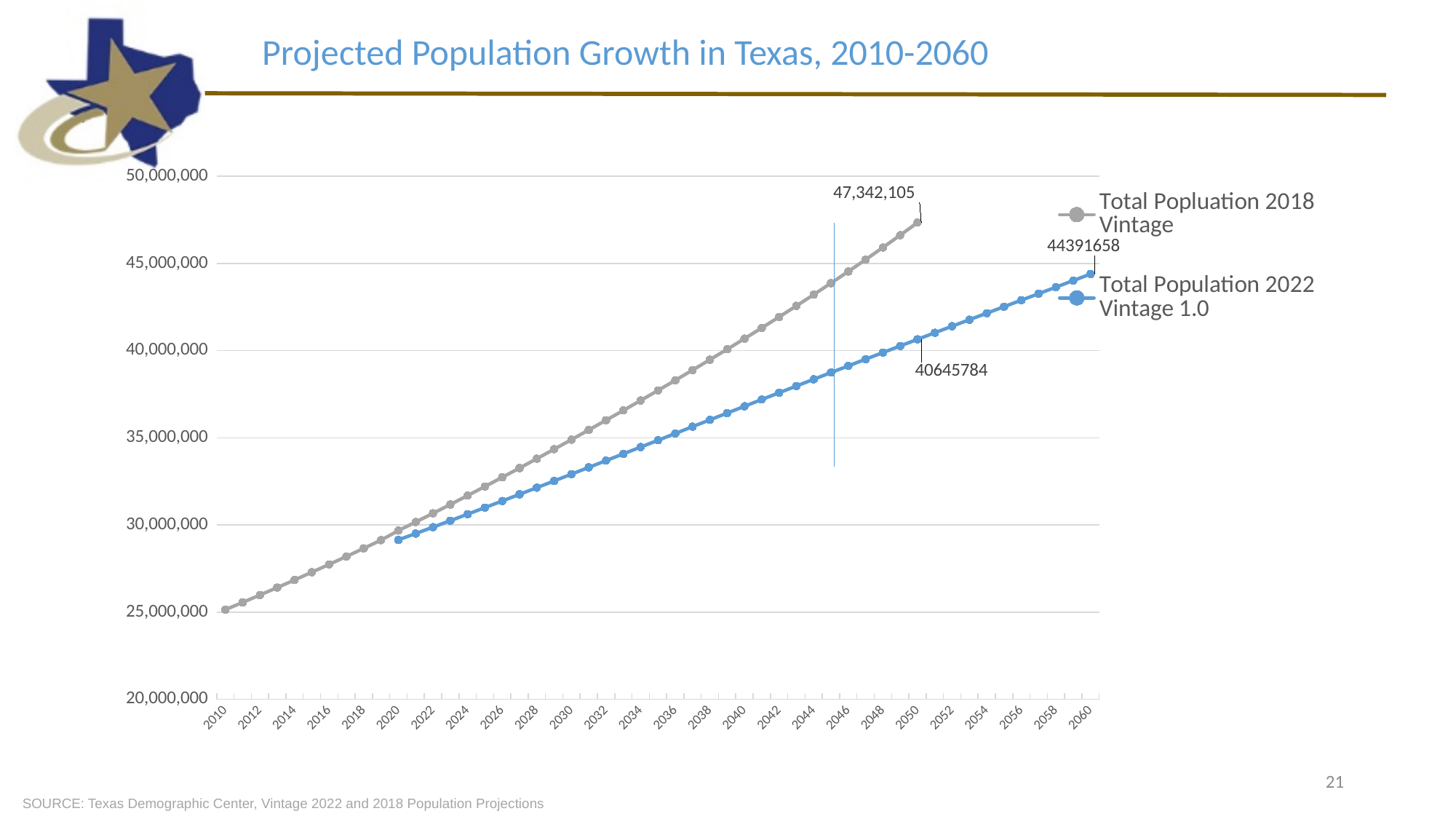
Do the values of the Total Population 2022 Vintage 1.0 series rise or fall from 2020 to 2060? rise At 2050, which series has the larger value: Total Popluation 2018 Vintage or Total Population 2022 Vintage 1.0? Total Popluation 2018 Vintage What is the title of the chart? Projected Population Growth in Texas, 2010-2060 What is the data label shown for the Total Popluation 2018 Vintage series at 2050? 47,342,105 What is the difference between the 2050 labelled values of the 2018 Vintage series and the 2022 Vintage 1.0 series? 6,696,321 What is the data label shown for the Total Population 2022 Vintage 1.0 series at 2060? 44391658 How many series does the legend list? 2 What is the data label shown for the Total Population 2022 Vintage 1.0 series at 2050? 40645784 What kind of chart is shown on the slide? line chart Is the value for the Total Popluation 2018 Vintage series at 2046 greater or less than 40,000,000? greater Is the value for the Total Popluation 2018 Vintage series at 2010 greater or less than 30,000,000? less Is the value for the Total Population 2022 Vintage 1.0 series at 2040 greater or less than 35,000,000? greater